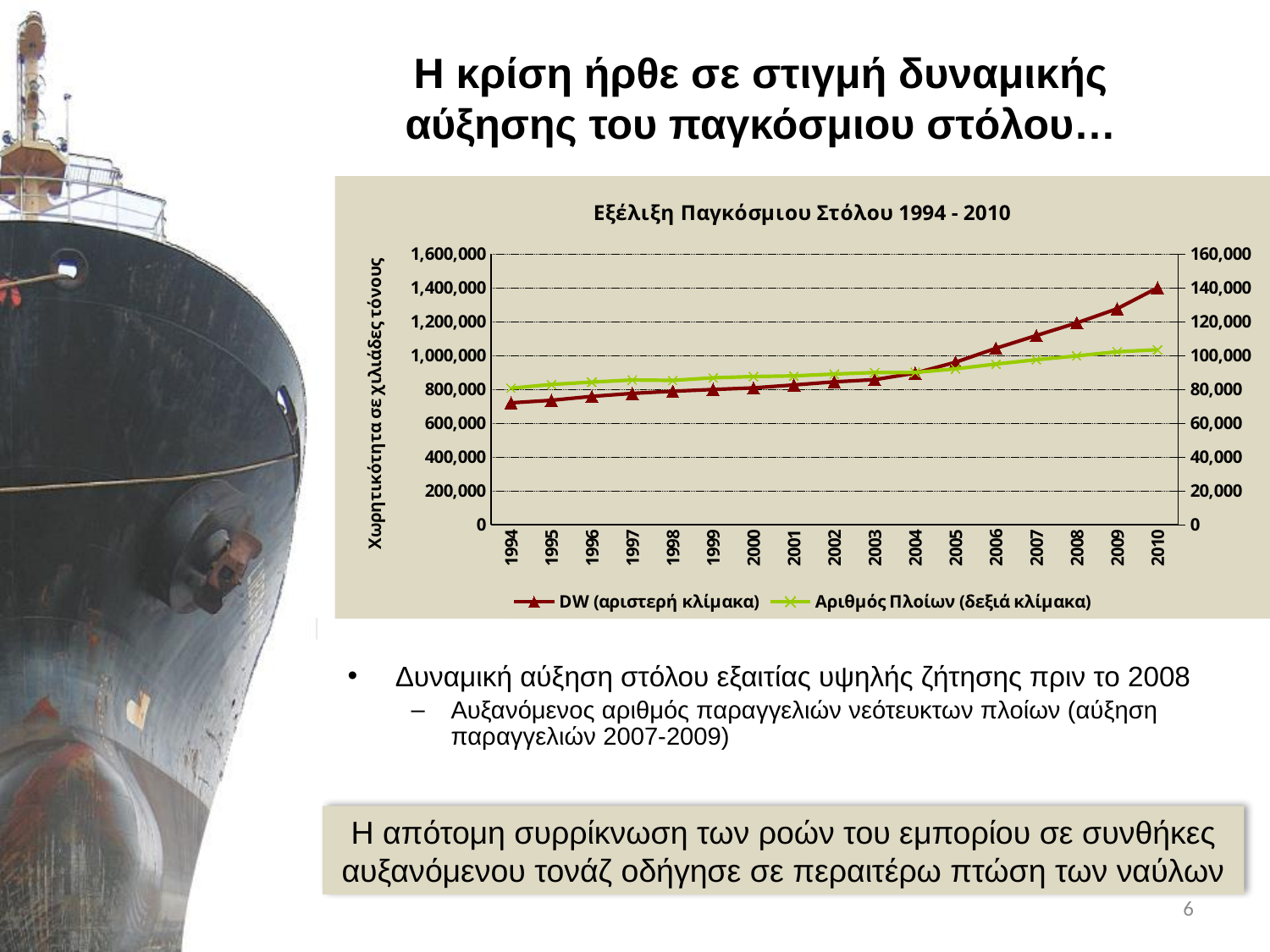
What is the label of the left vertical axis of the chart? Χωρητικότητα σε χιλιάδες τόνους Is the DW value for 1994 greater or less than 800,000? less Is the DW value for 2010 greater or less than 1,200,000? greater What kind of chart is shown on the slide? line chart How many years are plotted along the x axis of the chart? 17 Does the DW (αριστερή κλίμακα) series rise or fall from 1994 to 2010? rise How many series does the chart legend list? 2 In which year is the DW (αριστερή κλίμακα) series at its lowest? 1994 Is the Αριθμός Πλοίων value for 1994 greater or less than 100,000 on the right scale? less In which year is the DW (αριστερή κλίμακα) series at its highest? 2010 Which year has the larger DW value, 1994 or 2010? 2010 What is the title of the chart? Εξέλιξη Παγκόσμιου Στόλου 1994 - 2010